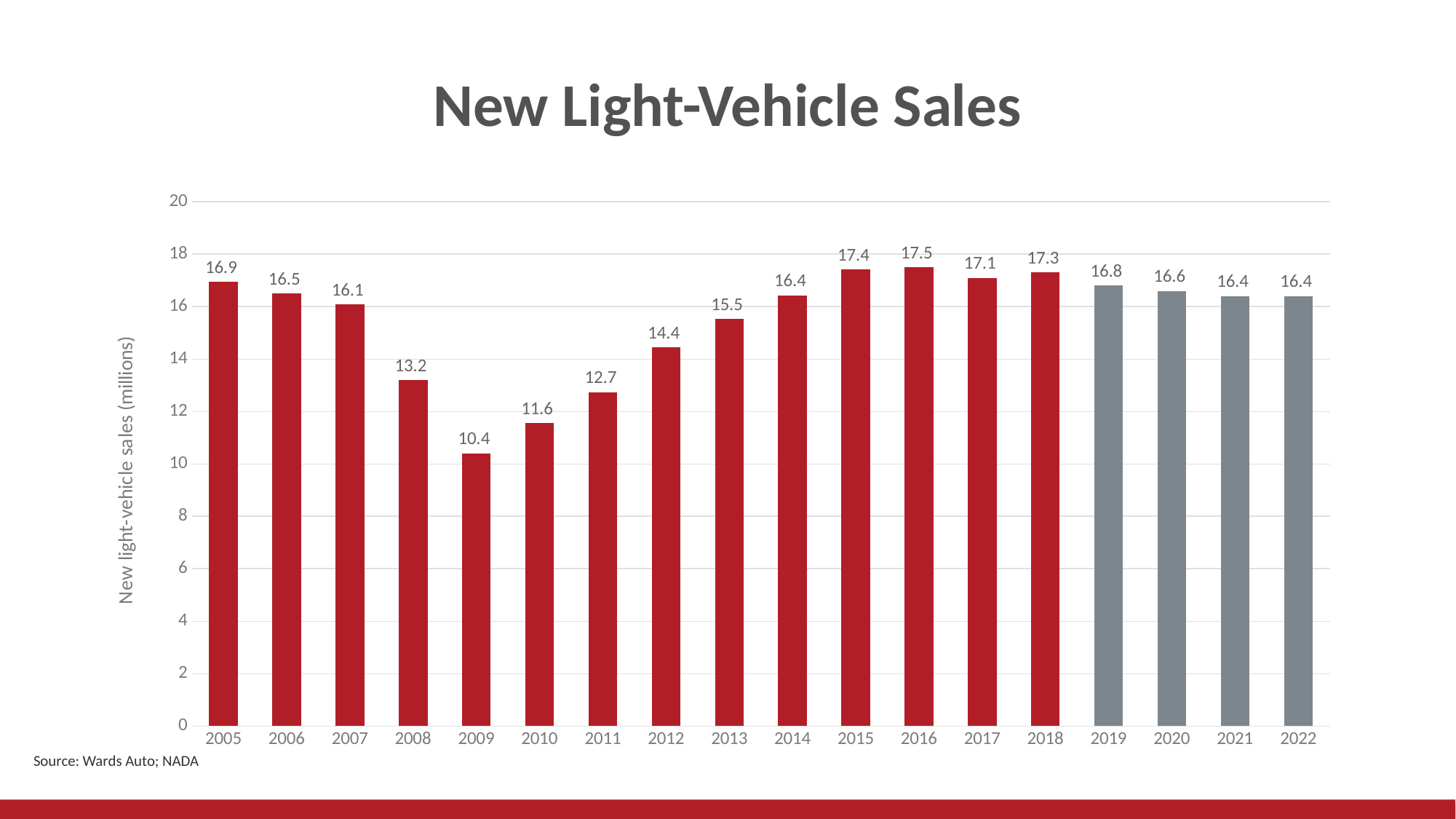
Do the values rise or fall from 2009 to 2016? rise What is the difference between the values for 2018 and 2019? 0.5 What is the difference between the values for 2005 and 2009? 6.5 How many years are shown on the x axis? 18 Is the value for 2010 greater or less than 12? less Which year has the lowest value? 2009 What is the value for 2009? 10.4 Which year has the highest value? 2016 What is the value for 2016? 17.5 Which is larger, the value for 2008 or the value for 2012? 2012 What kind of chart is this? bar chart What is the value for 2020? 16.6